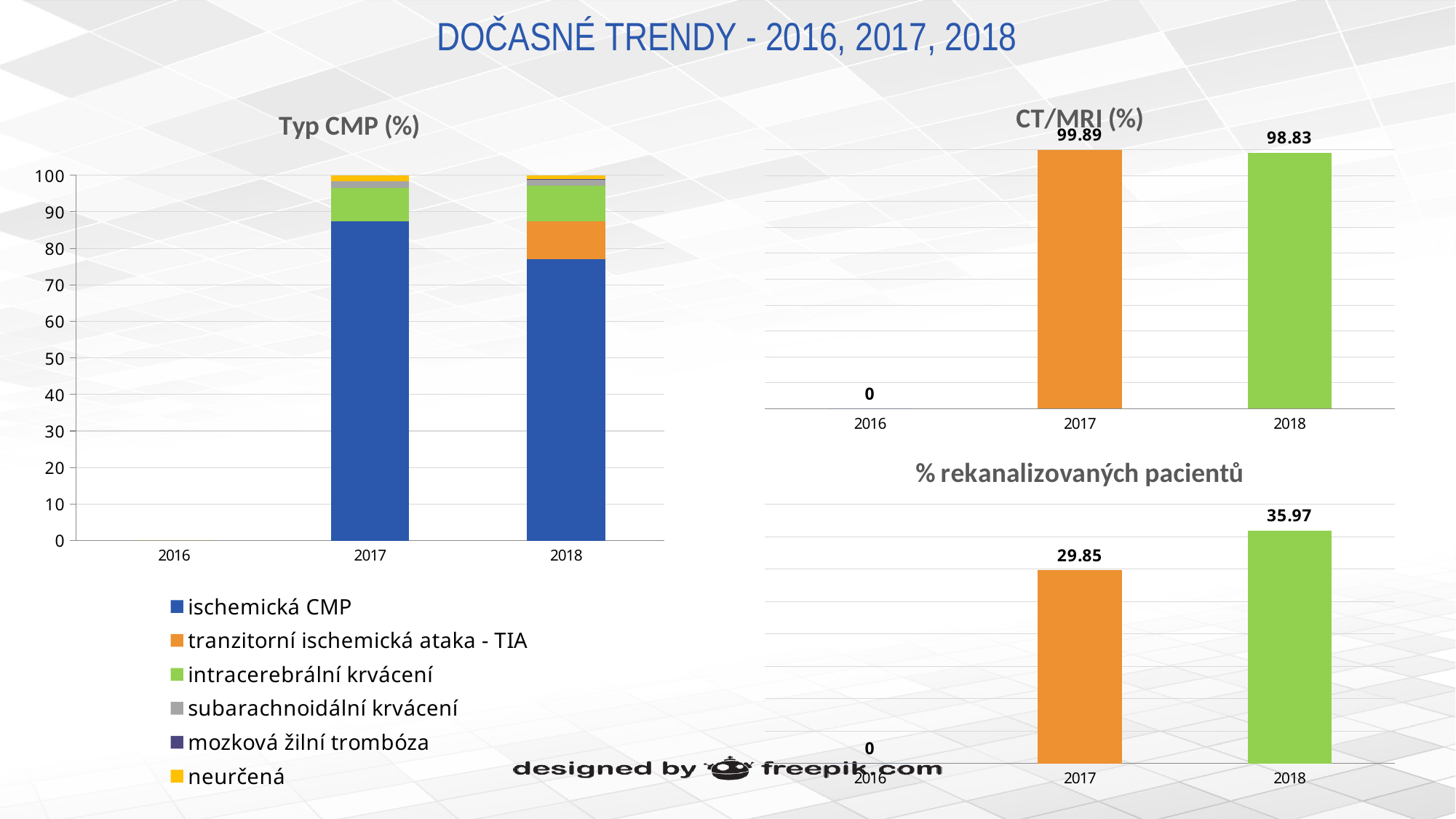
In the CT/MRI (%) chart, what is the value for 2018? 98.83 In the % rekanalizovaných pacientů chart, what is the value shown for 2016? 0 In the CT/MRI (%) chart, what is the difference between the 2017 and 2018 values? 1.06 What kind of chart is the Typ CMP (%) chart? stacked bar chart In the Typ CMP (%) chart, which year has the larger ischemická CMP value, 2017 or 2018? 2017 In the % rekanalizovaných pacientů chart, by how much does the 2018 value exceed the 2017 value? 6.12 In the % rekanalizovaných pacientů chart, which year has the highest value? 2018 In the % rekanalizovaných pacientů chart, what is the value for 2018? 35.97 In the % rekanalizovaných pacientů chart, what is the value for 2017? 29.85 In the Typ CMP (%) chart, is the value for ischemická CMP in 2017 greater or less than 80? greater In the CT/MRI (%) chart, what is the value for 2017? 99.89 In the Typ CMP (%) chart, how many series does the legend list? 6